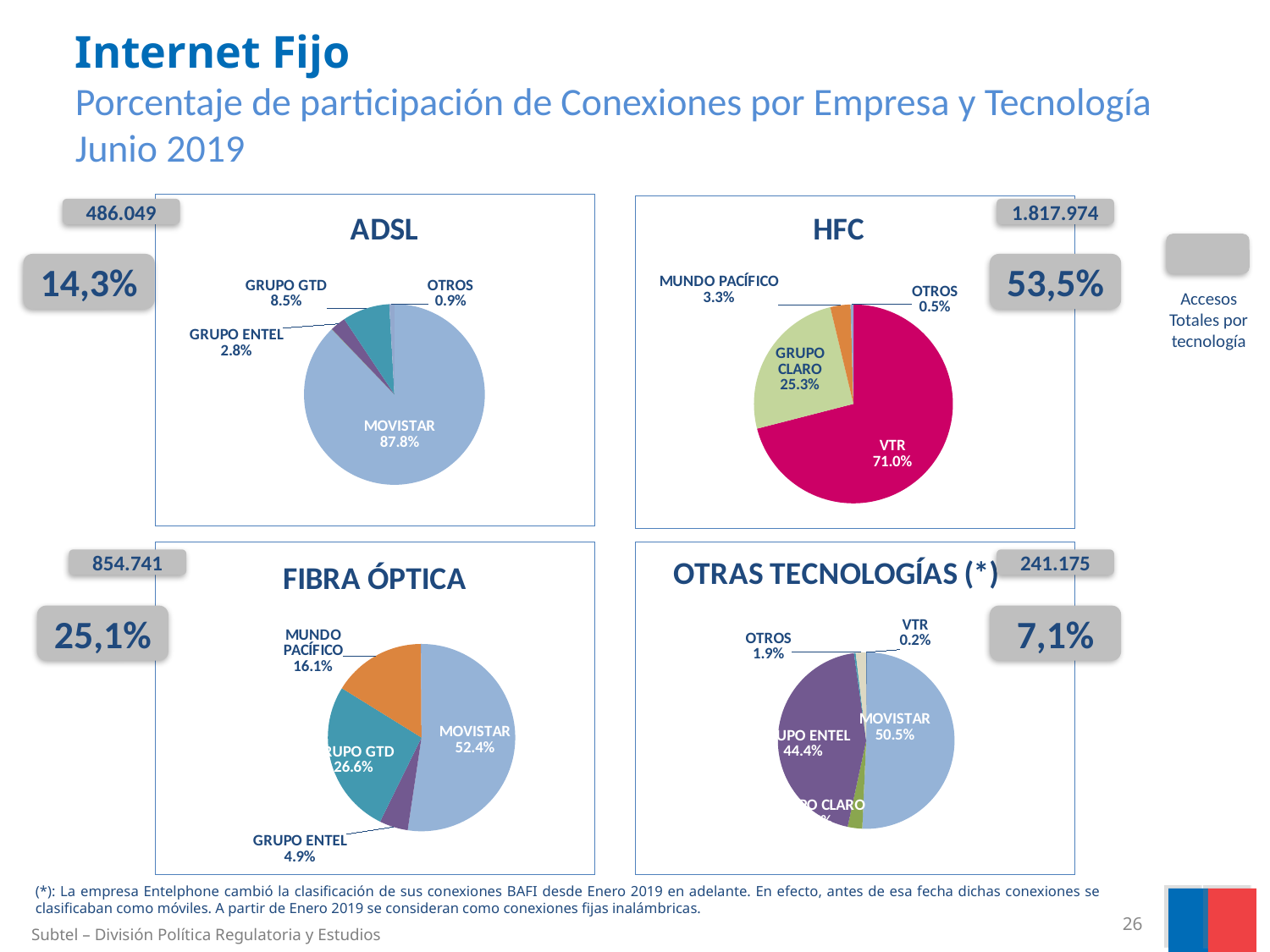
In the FIBRA ÓPTICA chart, what share does MUNDO PACÍFICO have? 16.1% In the OTRAS TECNOLOGÍAS (*) chart, what is the difference between the shares of MOVISTAR and GRUPO ENTEL? 6.1% In the ADSL chart, what share of connections does MOVISTAR have? 87.8% In the HFC chart, what share does VTR have? 71.0% In the OTRAS TECNOLOGÍAS (*) chart, what share does MOVISTAR have? 50.5% In the ADSL chart, what is the difference between the shares of GRUPO GTD and GRUPO ENTEL? 5.7% In the HFC chart, how many slices does the pie have? 4 In the FIBRA ÓPTICA chart, which is larger, the share of GRUPO GTD or the share of MUNDO PACÍFICO? GRUPO GTD What type of chart is used for the ADSL data? Pie chart In the HFC chart, what is the difference between the shares of VTR and GRUPO CLARO? 45.7% In the HFC chart, which company has the largest share? VTR